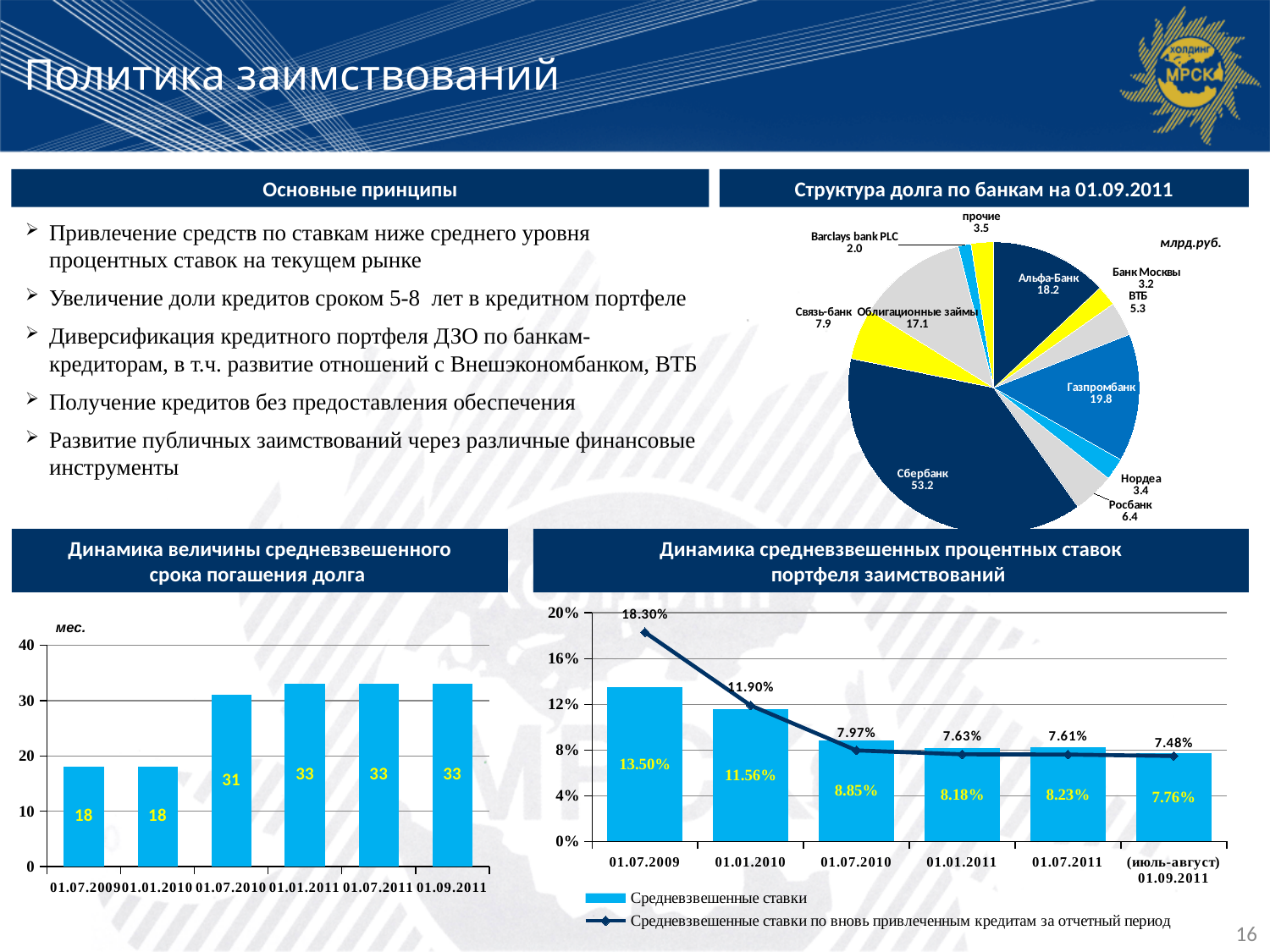
In the pie chart 'Структура долга по банкам на 01.09.2011', what is the difference between Газпромбанк and Альфа-Банк? 1.6 In the chart 'Динамика средневзвешенных процентных ставок портфеля заимствований', how many series does the legend list? 2 In the pie chart 'Структура долга по банкам на 01.09.2011', what is the value for Сбербанк? 53.2 In the pie chart 'Структура долга по банкам на 01.09.2011', what unit is indicated for the values? млрд.руб. In the pie chart 'Структура долга по банкам на 01.09.2011', which bank has the largest share of debt? Сбербанк In the chart 'Динамика средневзвешенных процентных ставок портфеля заимствований', what is the value of the line series for 01.07.2009? 18.30% In the chart 'Динамика средневзвешенных процентных ставок портфеля заимствований', what is the difference between the 'Средневзвешенные ставки' values for 01.07.2009 and 01.01.2010? 1.94% In the chart 'Динамика величины средневзвешенного срока погашения долга', do the values rise or fall from 01.07.2009 to 01.09.2011? rise In the chart 'Динамика величины средневзвешенного срока погашения долга', what is the value for 01.07.2010? 31 In the pie chart 'Структура долга по банкам на 01.09.2011', which is larger: ВТБ or Росбанк? Росбанк In the chart 'Динамика величины средневзвешенного срока погашения долга', how many bars are plotted? 6 In the chart 'Динамика средневзвешенных процентных ставок портфеля заимствований', what is the value of 'Средневзвешенные ставки' for 01.01.2010? 11.56%